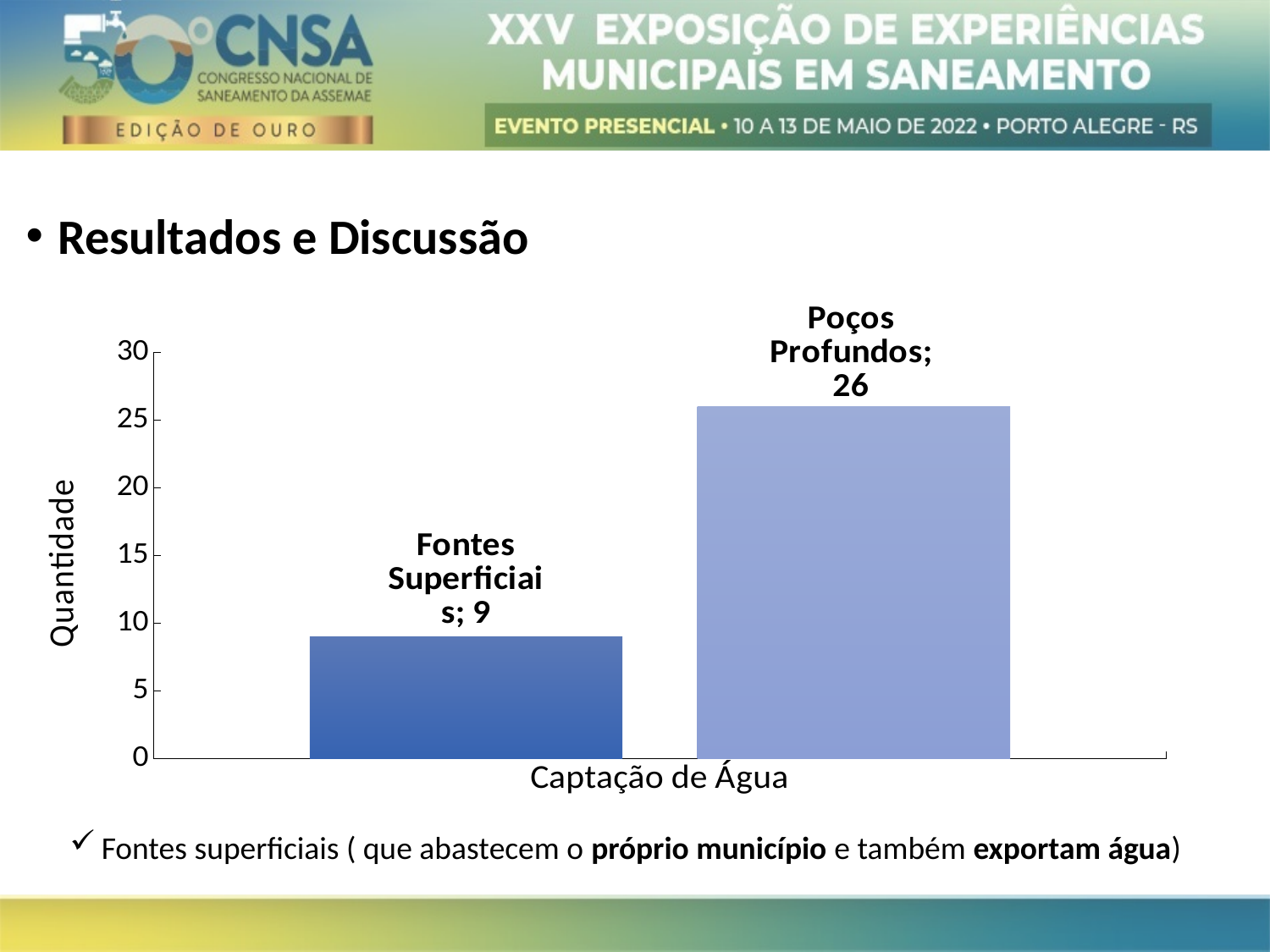
How many categories are shown in the chart? 2 What is the label of the vertical axis? Quantidade Which is larger, the value for Fontes Superficiais or the value for Poços Profundos? Poços Profundos Which category has the lowest value? Fontes Superficiais Which category has the highest value? Poços Profundos What is the label of the horizontal axis? Captação de Água What is the difference between the values for Poços Profundos and Fontes Superficiais? 17 What is the value for Fontes Superficiais? 9 What kind of chart is shown on the slide? bar chart Is the value for Poços Profundos greater or less than 25? greater What is the value for Poços Profundos? 26 Is the value for Fontes Superficiais greater or less than 10? less